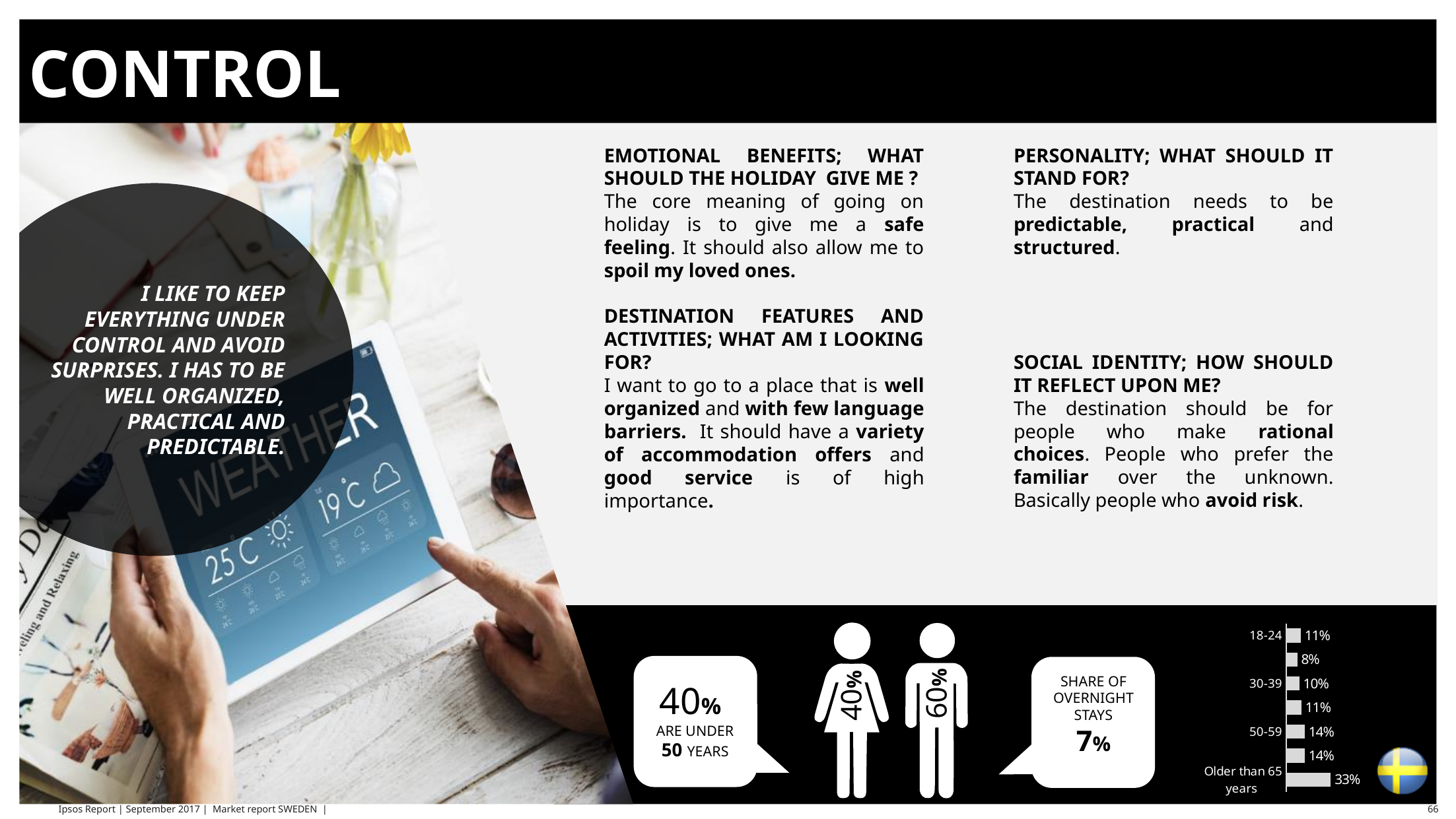
In the age-group bar chart, which is larger: the value for 50-59 or the value for 30-39? 50-59 In the age-group bar chart, which age group has the highest value? Older than 65 years In the age-group bar chart, what is the value for the 'Older than 65 years' group? 33% In the age-group bar chart, what is the difference between the 'Older than 65 years' value and the 50-59 value? 19 percentage points In the age-group bar chart, what is the value for the 18-24 group? 11% What type of chart is the age-group chart in the bottom right of the slide? Bar chart In the age-group bar chart, what is the difference between the 'Older than 65 years' value and the 18-24 value? 22 percentage points In the age-group bar chart, what is the value for the 30-39 group? 10% In the age-group bar chart, do the values generally rise or fall from the youngest group to the oldest group? Rise In the age-group bar chart, what is the value for the 50-59 group? 14% In the age-group bar chart, which is larger: the value for 18-24 or the value for 30-39? 18-24 How many bars does the age-group bar chart show? 7